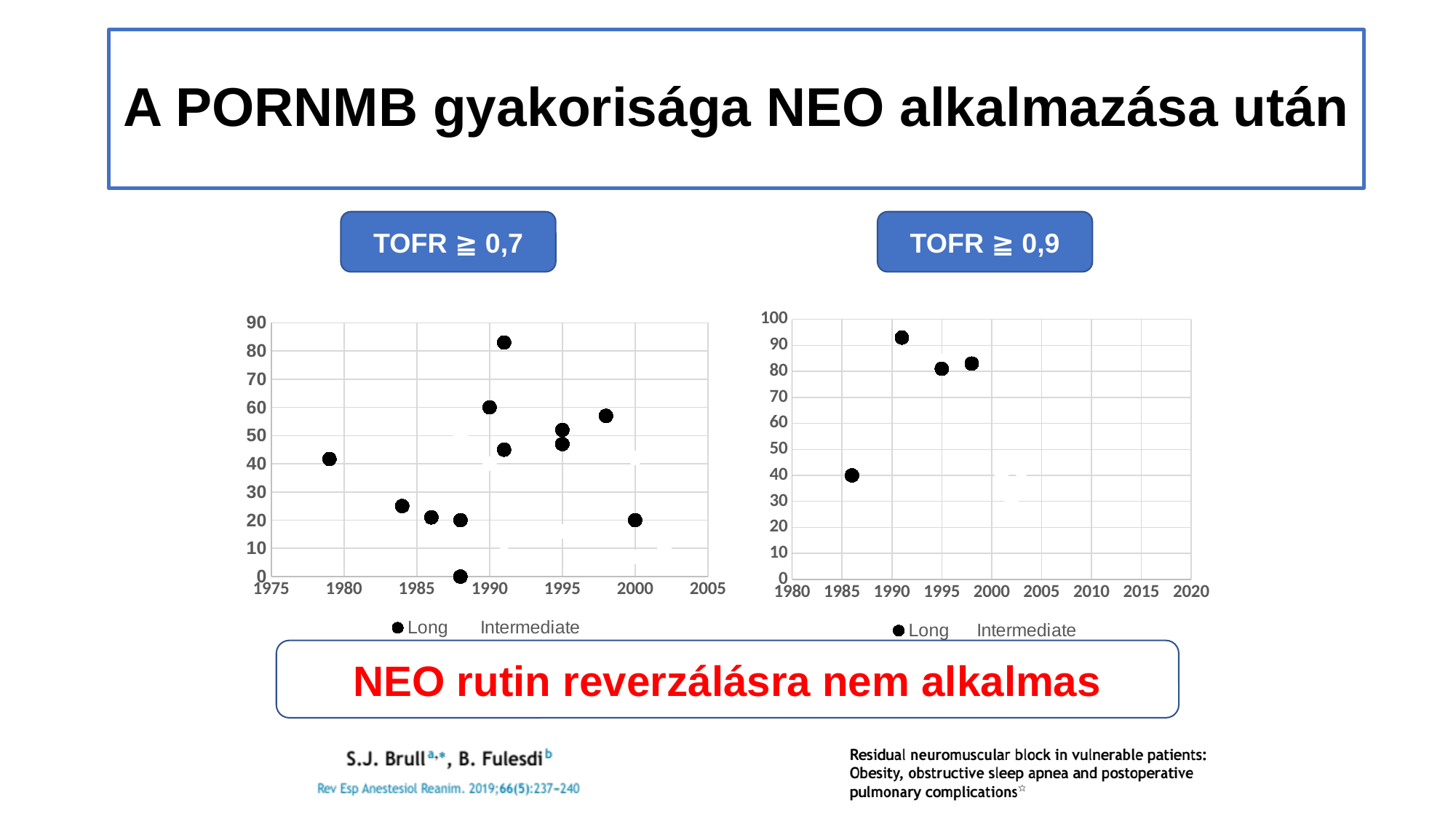
In the 'TOFR ≧ 0,7' chart, is the highest point (at 1991) greater or less than 70? greater How many data points are plotted in the 'TOFR ≧ 0,7' chart? 12 What kind of chart is the chart under the 'TOFR ≧ 0,7' label? scatter chart In the 'TOFR ≧ 0,9' chart, in which year is the lowest plotted point? 1986 How many series does the legend of the 'TOFR ≧ 0,7' chart list? 2 How many data points are plotted in the 'TOFR ≧ 0,9' chart? 4 In the 'TOFR ≧ 0,9' chart, in which year is the highest plotted point? 1991 In the 'TOFR ≧ 0,7' chart, in which year is the lowest plotted point? 1988 What is the maximum value shown on the y axis of the 'TOFR ≧ 0,9' chart? 100 In the 'TOFR ≧ 0,7' chart, in which year is the highest plotted point? 1991 In the 'TOFR ≧ 0,9' chart, is the value of the point at 1991 greater or less than 80? greater In the 'TOFR ≧ 0,9' chart, is the value of the point at 1986 greater or less than 60? less